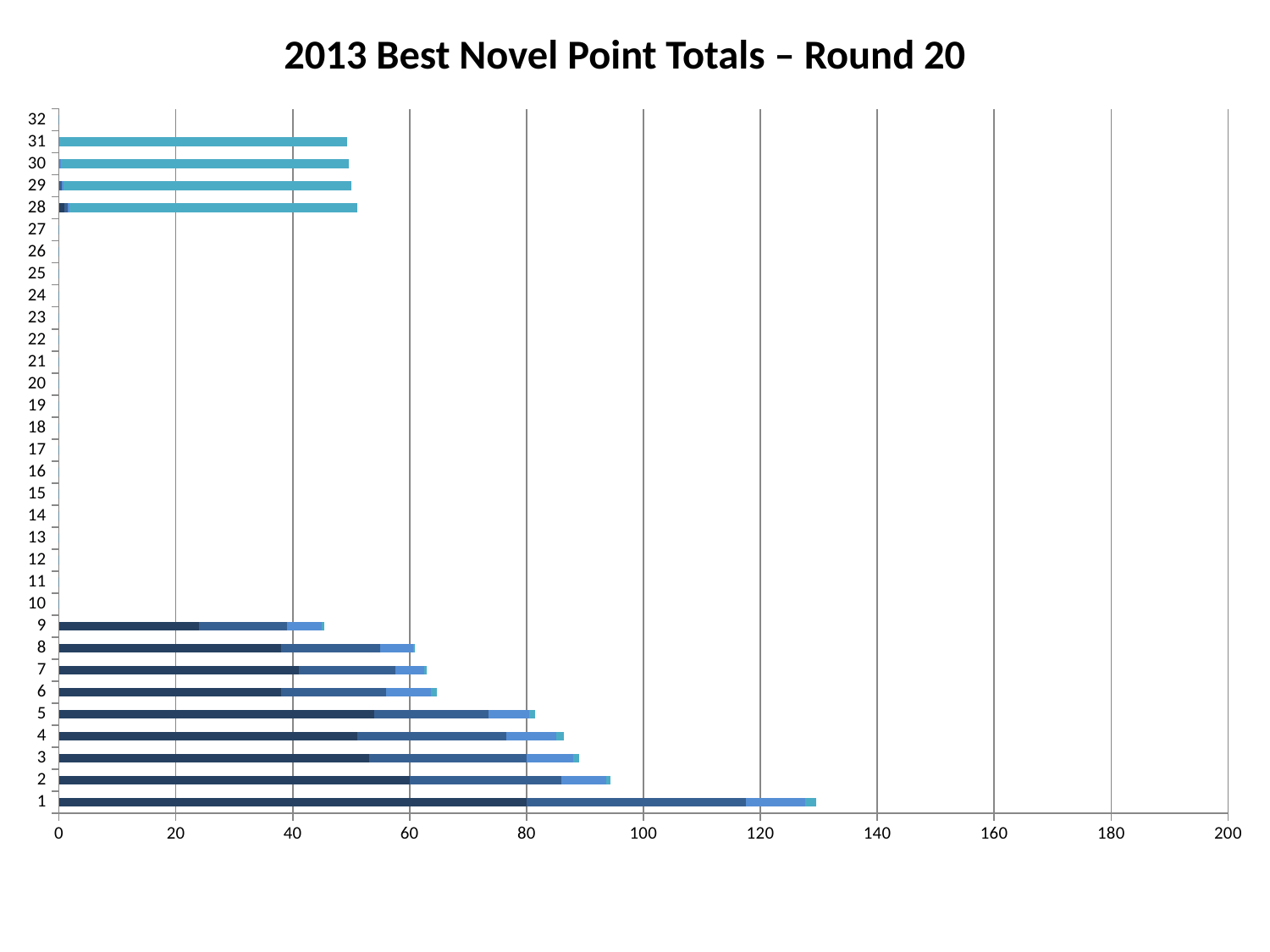
How many categories are listed on the vertical axis? 32 What kind of chart is shown on the slide? Bar chart Is the value for category 2 greater or less than 100? less What is the highest value shown on the horizontal axis? 200 What is the title of the chart? 2013 Best Novel Point Totals – Round 20 Which has a larger value, category 1 or category 2? Category 1 Is the value for category 1 greater or less than 120? greater Is the value for category 6 greater or less than 60? greater Which has a larger value, category 5 or category 6? Category 5 Which category has the highest point total? 1